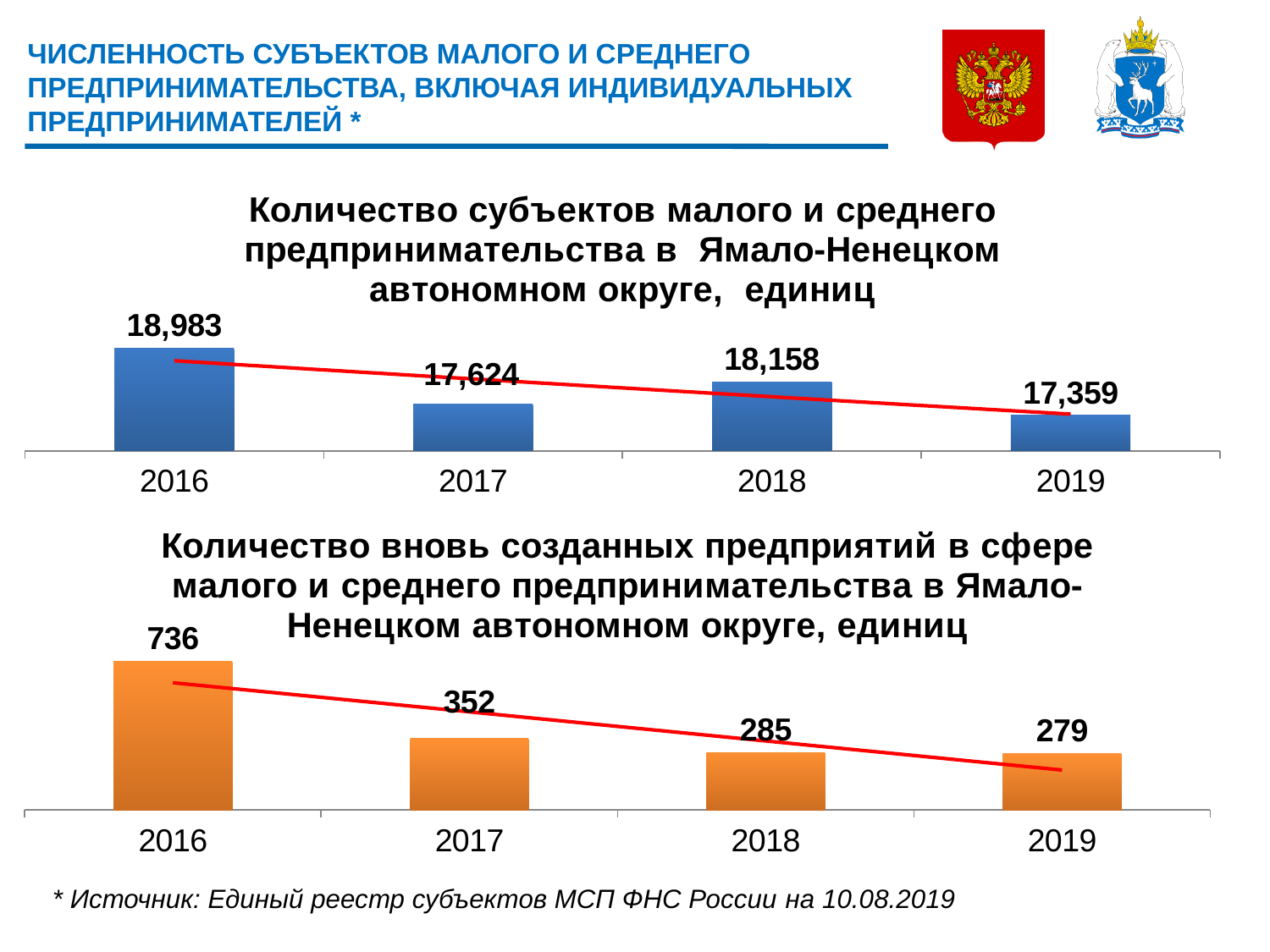
In the top chart, which year has the highest value? 2016 In the bottom chart, what is the value for 2018? 285 In the bottom chart, do the values generally rise or fall from 2016 to 2019? fall What type of chart is the top chart? bar chart In the top chart, which is larger: the value for 2017 or the value for 2018? 2018 How many years (categories) are shown in the bottom chart? 4 In the top chart, which year has the lowest value? 2019 In the top chart (number of SME entities in Yamalo-Nenets Autonomous Okrug), what is the value for 2016? 18,983 In the top chart, what is the value for 2019? 17,359 In the bottom chart, what is the difference between the 2016 and 2019 values? 457 In the top chart, what is the difference between the 2016 and 2017 values? 1,359 In the bottom chart (number of newly created SME enterprises), what is the value for 2016? 736